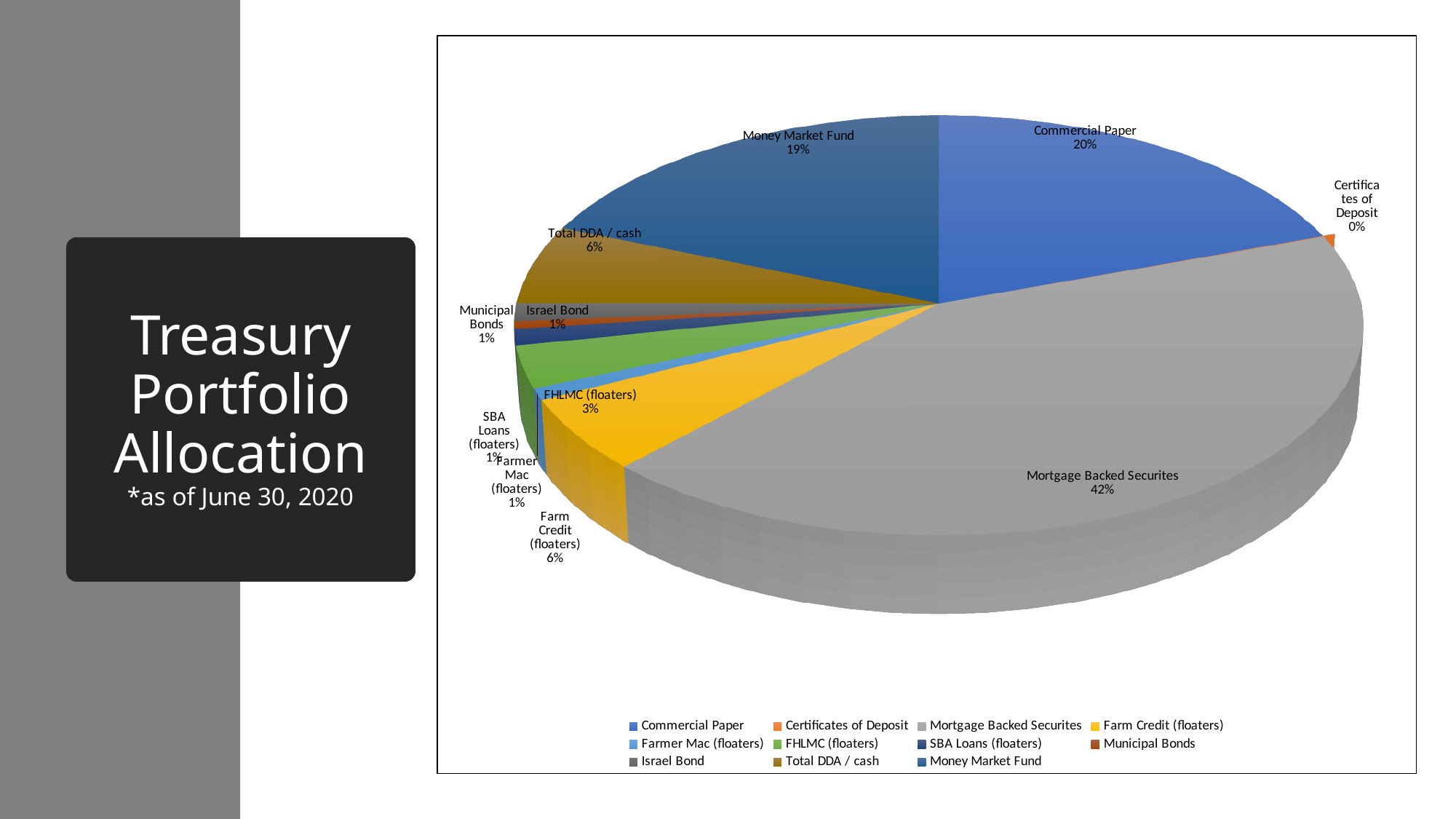
What is the difference in percentage points between Mortgage Backed Securites and Commercial Paper? 22 Which is larger, Commercial Paper or Money Market Fund? Commercial Paper What date does the slide say the portfolio allocation is as of? June 30, 2020 What percentage is shown for Money Market Fund? 19% What percentage is shown for FHLMC (floaters)? 3% Which category has the largest share of the pie? Mortgage Backed Securites How many categories does the legend list? 11 What percentage is shown for Total DDA / cash? 6% What percentage is shown for Commercial Paper? 20% What type of chart is shown on the slide? pie chart Which category has the smallest share of the pie? Certificates of Deposit What share of the portfolio is Mortgage Backed Securites? 42%